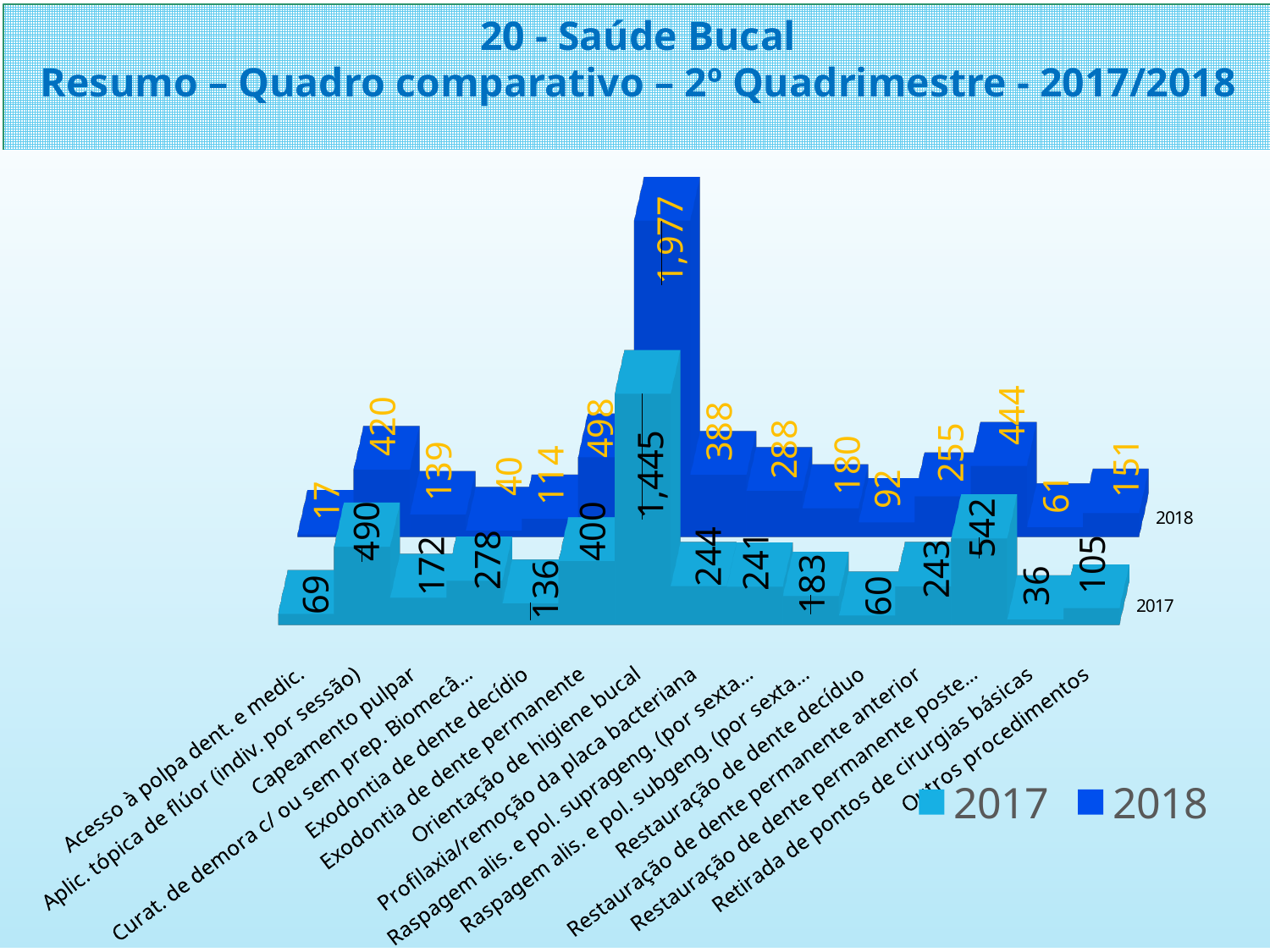
What is the 2017 value for Exodontia de dente permanente? 400 What kind of chart is shown on the slide? Bar chart What is the 2018 value for Orientação de higiene bucal? 1,977 What is the 2017 value for Retirada de pontos de cirurgias básicas? 36 Which is larger for Restauração de dente permanente poste..., the 2017 value or the 2018 value? 2017 What is the 2017 value for Orientação de higiene bucal? 1,445 How many categories are shown on the x axis? 15 What is the difference between the 2018 and 2017 values for Orientação de higiene bucal? 532 What is the 2018 value for Aplic. tópica de flúor (indiv. por sessão)? 420 How many series does the legend list? 2 Which category has the highest 2018 value? Orientação de higiene bucal Which category has the lowest 2018 value? Acesso à polpa dent. e medic.